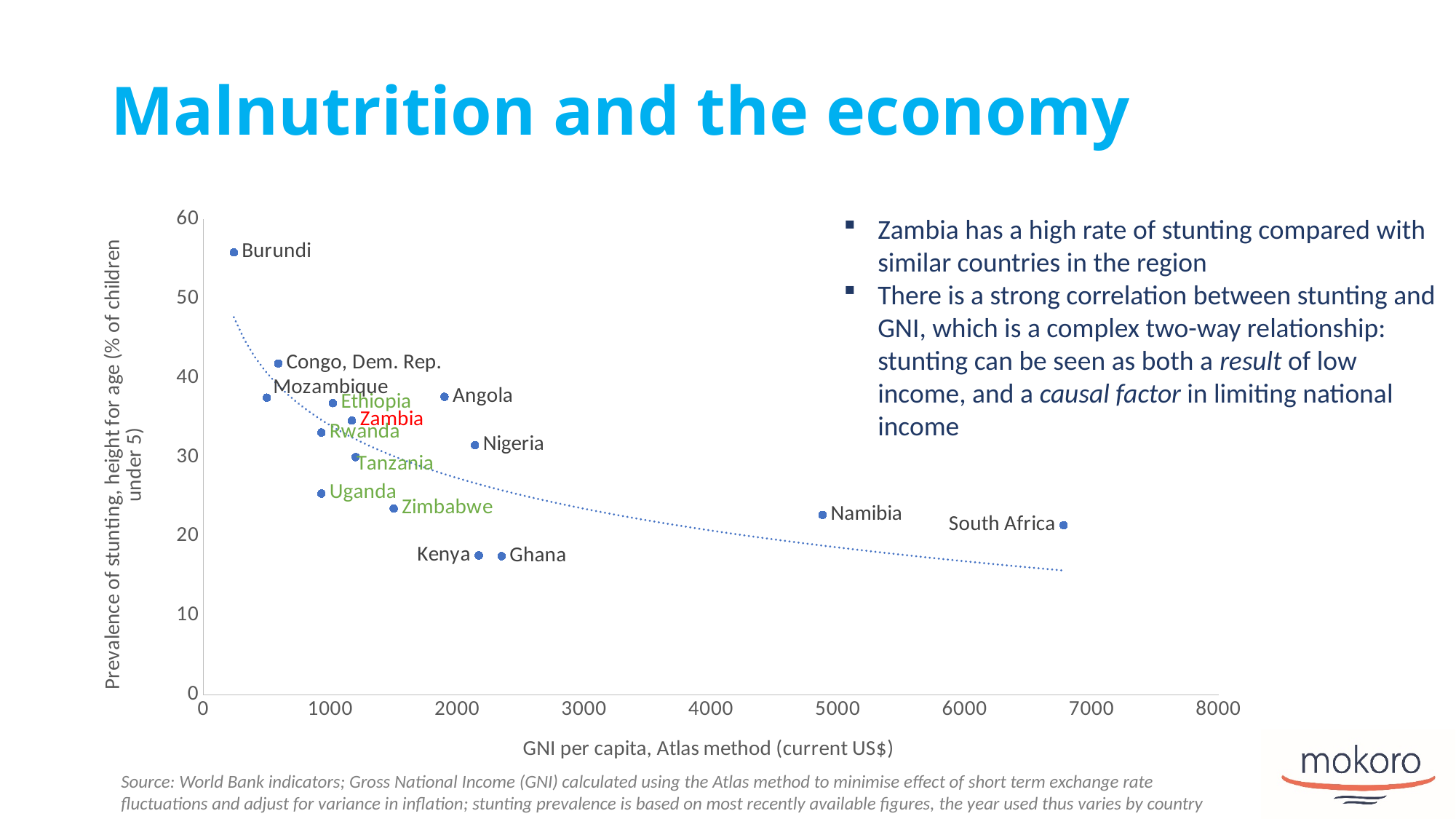
Is the stunting prevalence for Zambia greater or less than 30? greater Which country has a higher GNI per capita, Nigeria or Uganda? Nigeria Is the GNI per capita for Namibia greater or less than 4000? greater How many countries are plotted in the chart? 15 As GNI per capita increases along the x axis, does the prevalence of stunting generally rise or fall? Fall Which country has a higher prevalence of stunting, Angola or Zimbabwe? Angola What is the label of the x axis of the chart? GNI per capita, Atlas method (current US$) Which country has the highest GNI per capita in the chart? South Africa Which country has the highest prevalence of stunting in the chart? Burundi What kind of chart is shown on the slide? Scatter chart Is the stunting prevalence for Kenya greater or less than 20? less